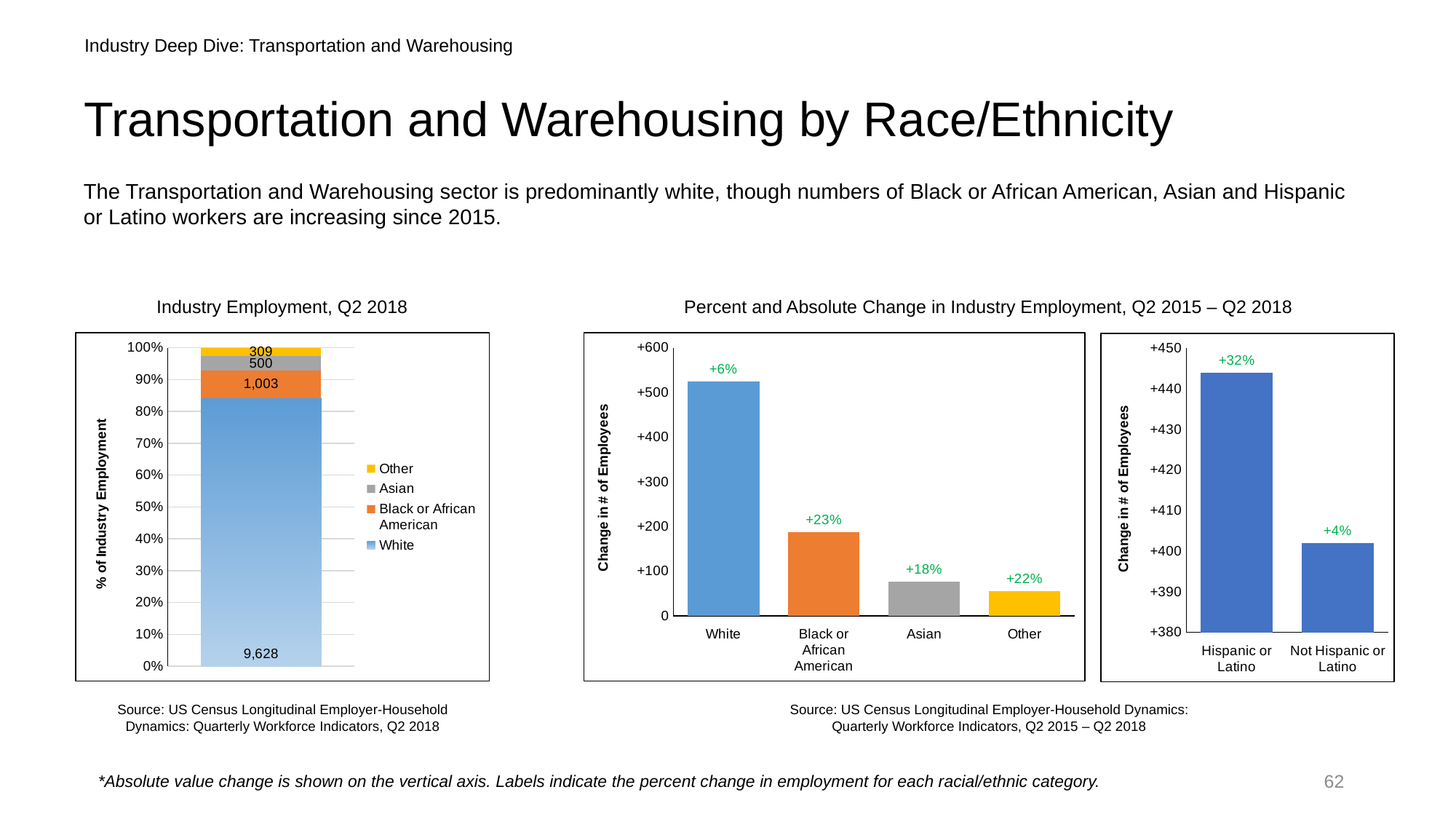
In the rightmost chart (Hispanic or Latino vs Not Hispanic or Latino), what percent change label is shown for Hispanic or Latino? +32% In the 'Industry Employment, Q2 2018' chart, what is the difference between the White value and the Black or African American value? 8,625 How many categories are shown on the x axis of the middle chart (change in employment by race)? 4 How many entries does the legend of the 'Industry Employment, Q2 2018' chart list? 4 In the 'Industry Employment, Q2 2018' chart, what is the value shown for Asian? 500 In the middle chart (change in employment by race), what percent change label is shown for Black or African American? +23% In the middle chart (change in employment by race), is the change in number of employees for White greater or less than +500? greater In the middle chart (change in employment by race), which category has the largest change in number of employees? White In the middle chart (change in employment by race), which category has the smallest change in number of employees? Other In the 'Industry Employment, Q2 2018' chart, what is the value shown for White? 9,628 In the rightmost chart, which has the larger change in number of employees: Hispanic or Latino or Not Hispanic or Latino? Hispanic or Latino In the 'Industry Employment, Q2 2018' chart, what is the total of all segments in the stacked bar? 11,440